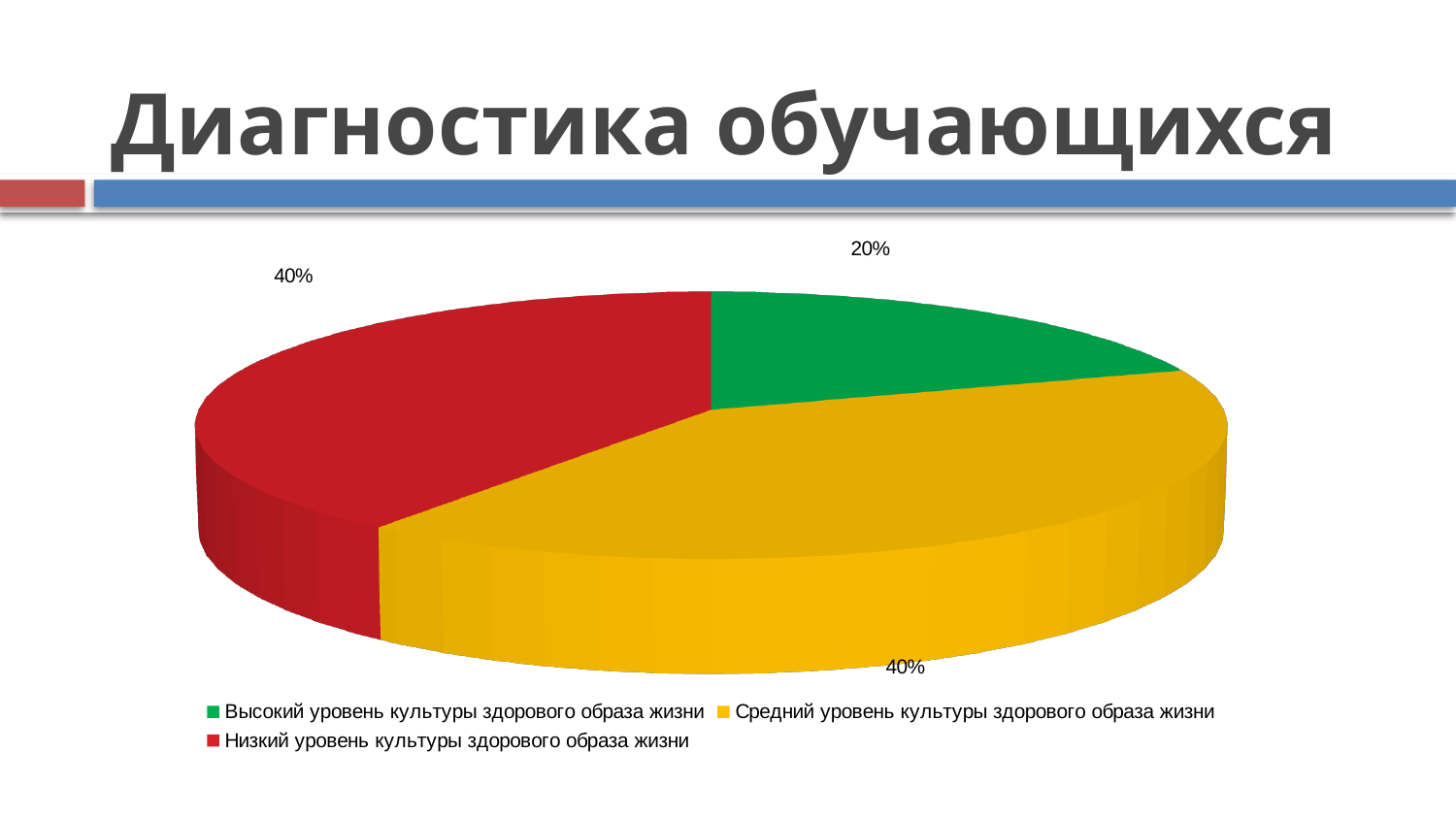
What is the value for "Низкий уровень культуры здорового образа жизни"? 40% How many entries does the legend list? 3 What is the value for "Средний уровень культуры здорового образа жизни"? 40% Which is larger: the slice for "Средний уровень культуры здорового образа жизни" or the slice for "Высокий уровень культуры здорового образа жизни"? Средний уровень культуры здорового образа жизни What is the difference between the values for "Низкий уровень культуры здорового образа жизни" and "Высокий уровень культуры здорового образа жизни"? 20% How many slices does the pie chart have? 3 What colour is the slice for "Низкий уровень культуры здорового образа жизни"? Red What is the value for "Высокий уровень культуры здорового образа жизни"? 20% What is the title of the slide containing the chart? Диагностика обучающихся What kind of chart is shown on the slide? Pie chart Which category has the smallest slice of the pie? Высокий уровень культуры здорового образа жизни What share of the pie does the green slice represent? 20%